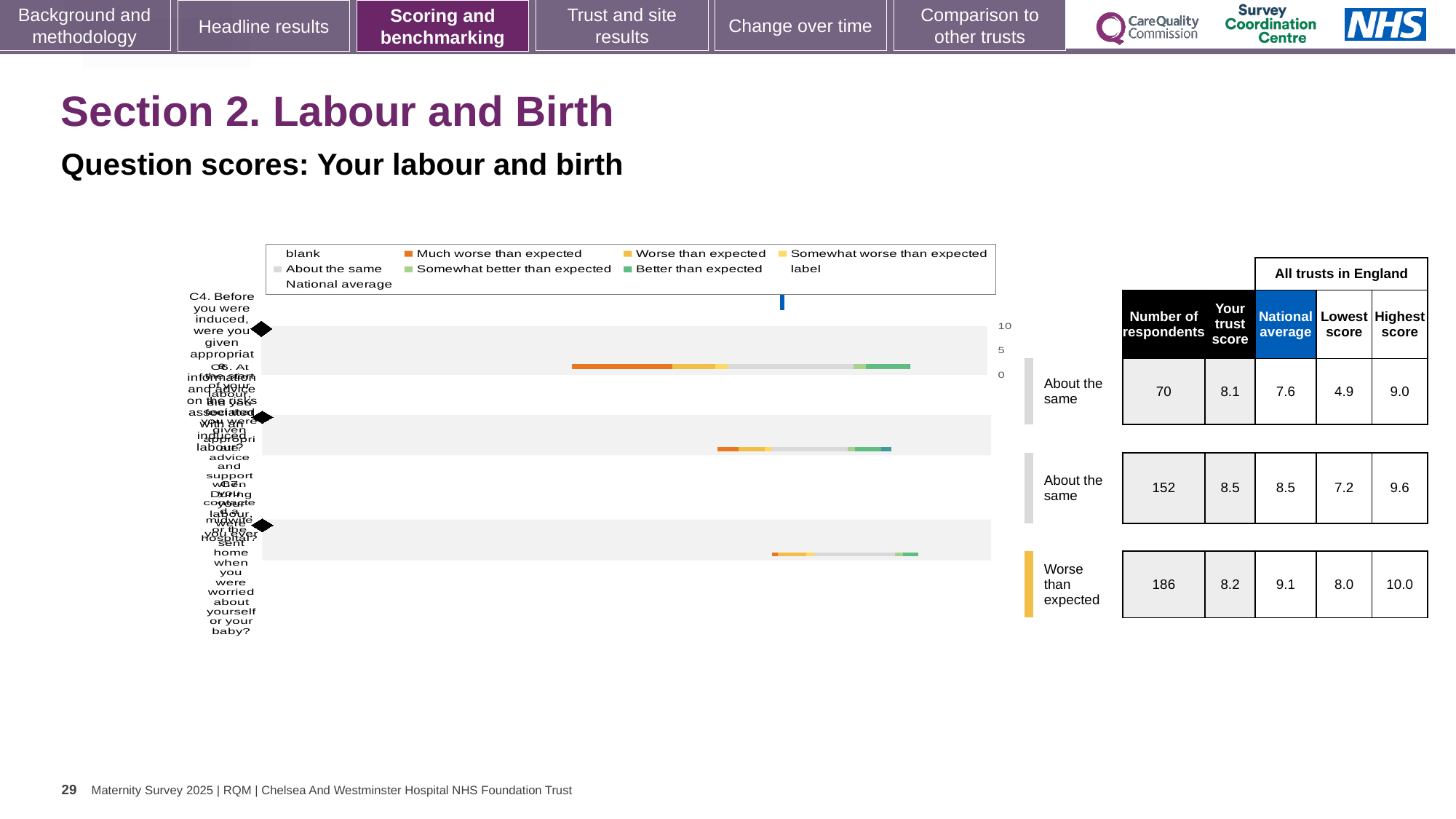
In the table beside the chart, what is the national average for the row rated 'Worse than expected'? 9.1 In the table beside the chart, which row has the largest number of respondents? the third row (Worse than expected) In the table beside the chart, what is the trust score for the row rated 'Worse than expected'? 8.2 In the table beside the chart, for the first row, which is larger: the trust score or the national average? trust score In the table beside the chart, what is the lowest score for the first row? 4.9 Which colour does the legend use for 'Much worse than expected'? orange In the table beside the chart, what is the highest score for the row rated 'Worse than expected'? 10.0 What kind of chart is shown on the slide? bar chart How many question rows (bars) are plotted in the chart? 3 In the table beside the chart, what is the number of respondents for the row rated 'Worse than expected'? 186 In the table beside the chart, what is the difference between the national average and the trust score for the row rated 'Worse than expected'? 0.9 What is the highest tick value shown on the chart's axis? 10